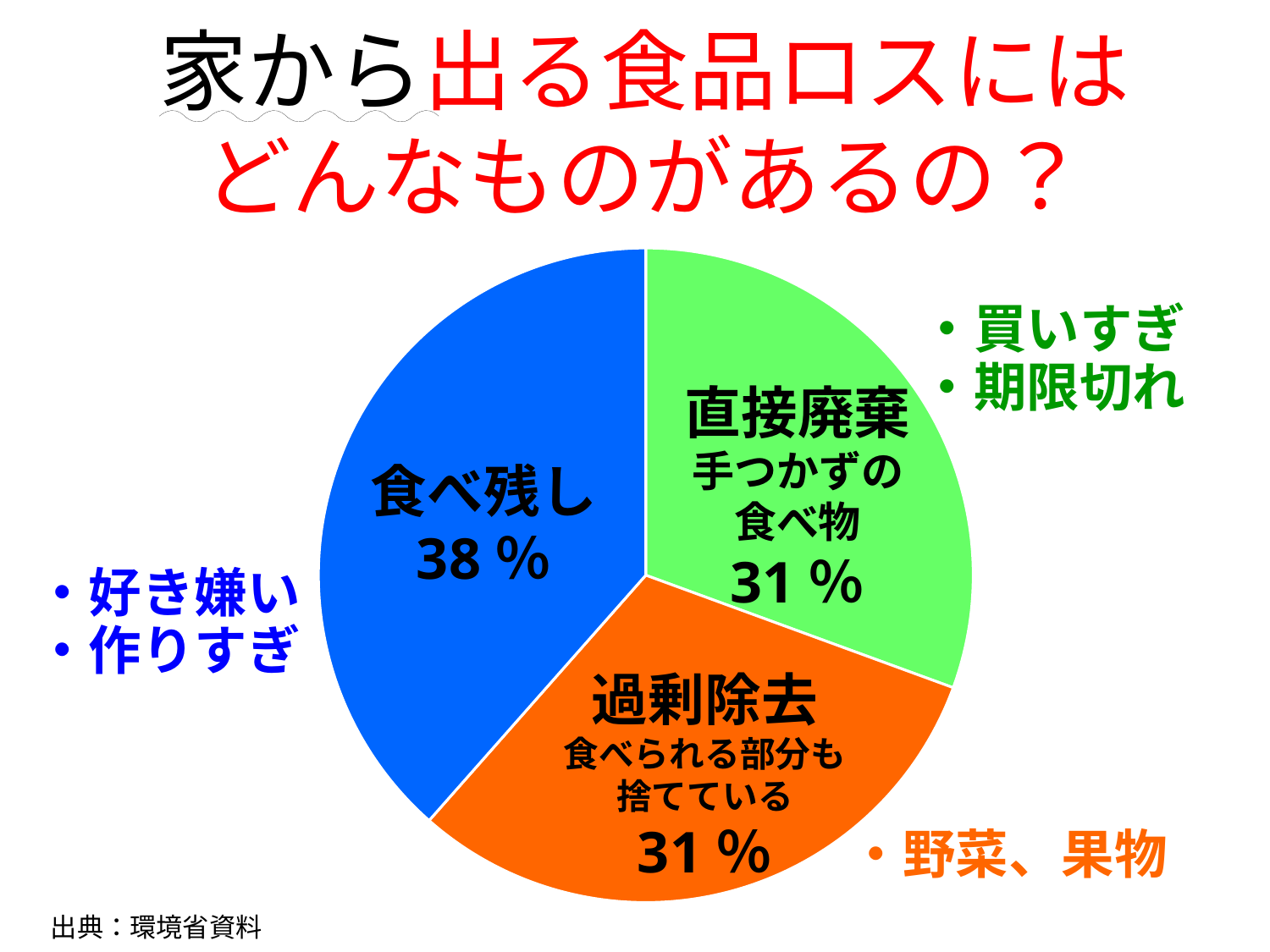
How many slices does the pie chart have? 3 What percentage does the 過剰除去 slice represent? 31 % What is the combined share of 直接廃棄 and 過剰除去? 62 % What percentage does the 直接廃棄 slice represent? 31 % What colour is the 食べ残し slice? blue What colour is the 過剰除去 slice? orange What percentage does the 食べ残し slice represent? 38 % What kind of chart is shown on the slide? pie chart Which slice of the pie is the largest? 食べ残し Which is larger, the 食べ残し slice or the 過剰除去 slice? 食べ残し What is the difference in percentage points between 食べ残し and 直接廃棄? 7